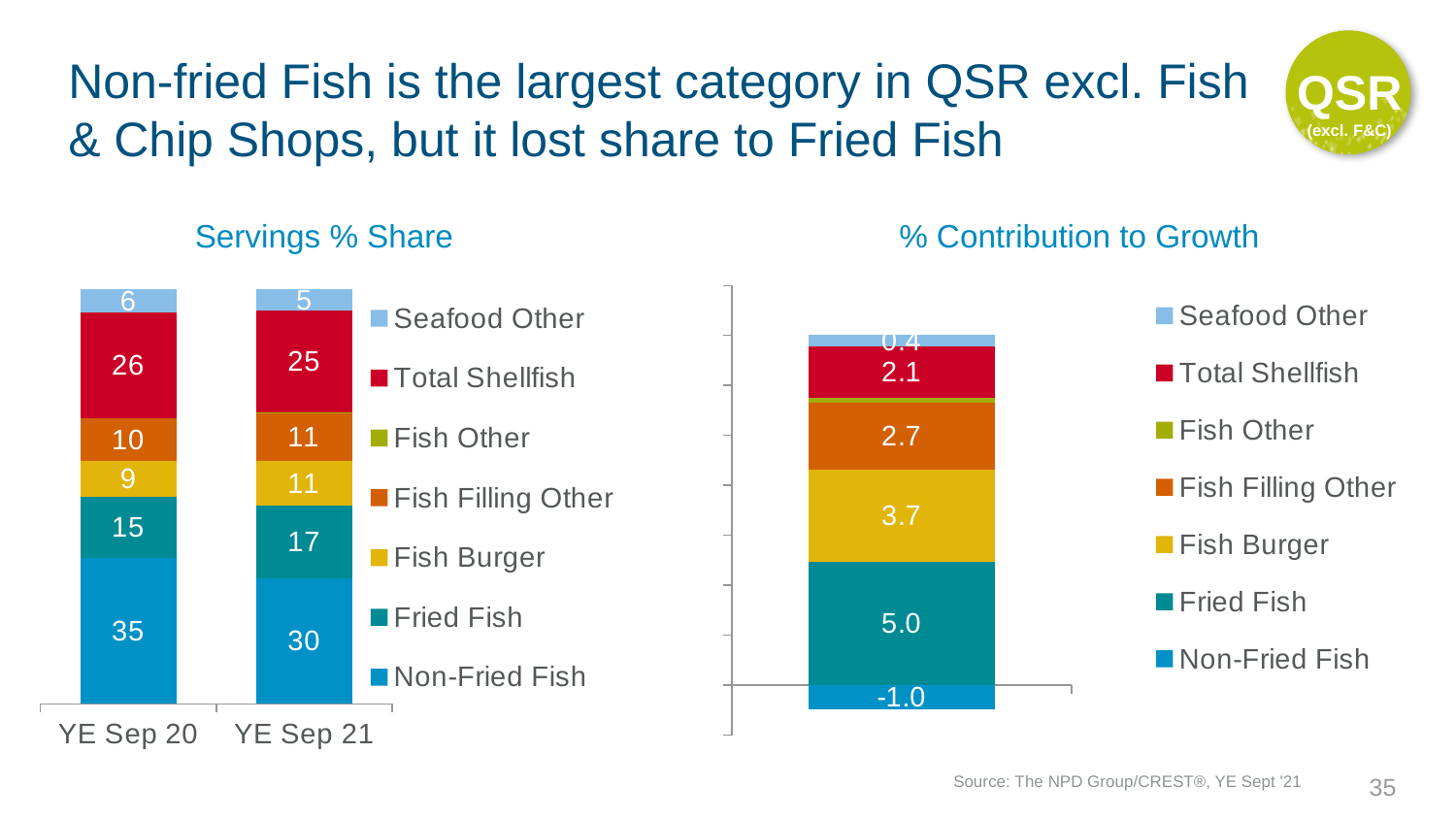
In the Servings % Share chart, how many bars (time periods) are shown? 2 In the Servings % Share chart, what is the value for Non-Fried Fish in YE Sep 20? 35 In the % Contribution to Growth chart, which category has the lowest contribution? Non-Fried Fish In the % Contribution to Growth chart, what is the value for Non-Fried Fish? -1.0 In the Servings % Share chart, which segment is the largest in YE Sep 21? Non-Fried Fish In the Servings % Share chart, by how much did the Non-Fried Fish share fall from YE Sep 20 to YE Sep 21? 5 How many series does the legend of the % Contribution to Growth chart list? 7 In the % Contribution to Growth chart, what is the value for Fried Fish? 5.0 In the Servings % Share chart, what is the value for Total Shellfish in YE Sep 20? 26 In the Servings % Share chart, is the Fish Burger value larger in YE Sep 20 or YE Sep 21? YE Sep 21 In the Servings % Share chart, what is the value for Non-Fried Fish in YE Sep 21? 30 In the Servings % Share chart, what is the value for Fried Fish in YE Sep 21? 17